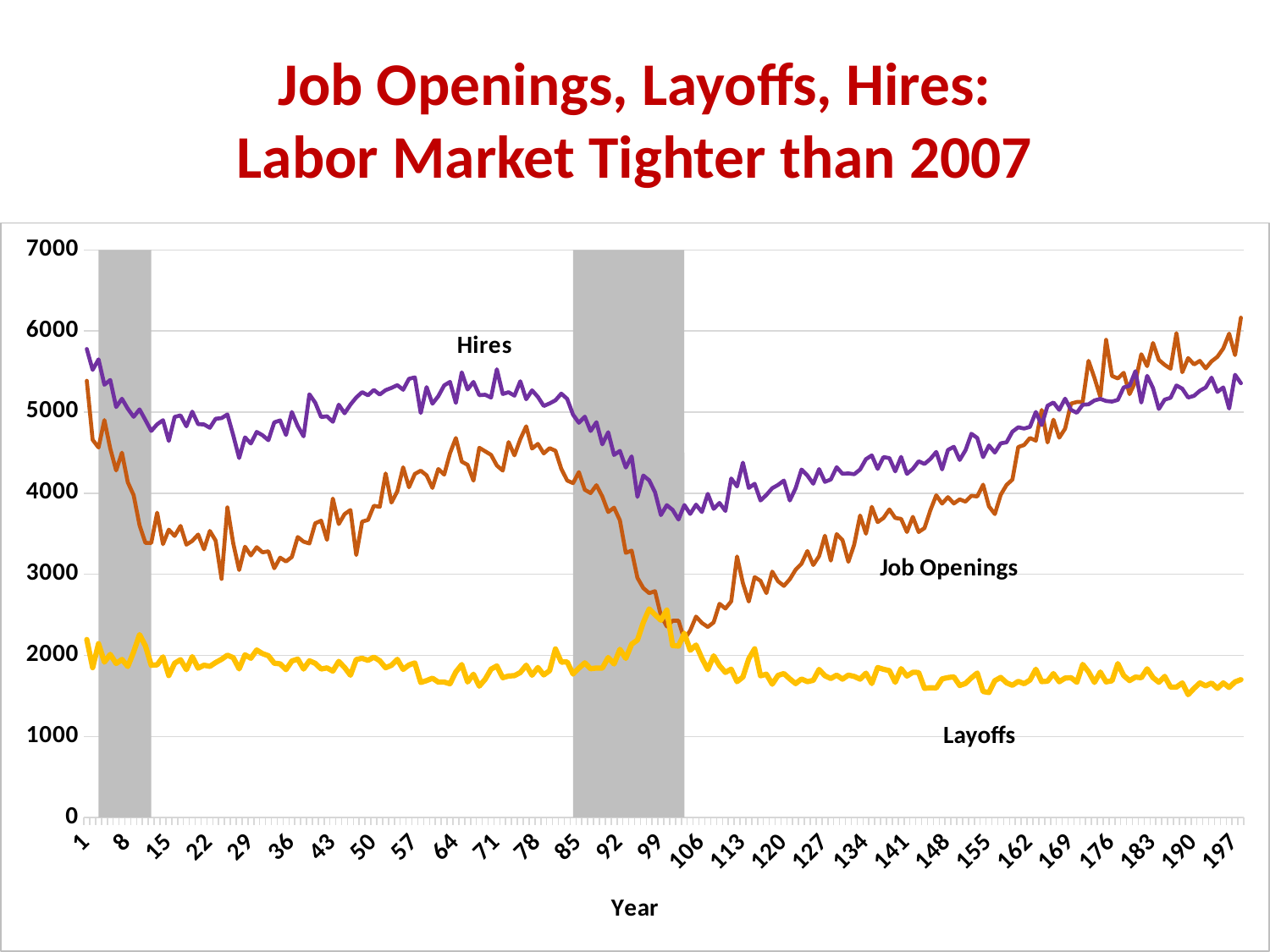
Is the value of Layoffs at year 197 greater or less than 2000? less Is the value of Hires at year 1 greater or less than 5000? greater What kind of chart is shown on the slide? Line chart Do Job Openings rise or fall between year 106 and year 197? Rise At year 1, which is higher: Hires or Job Openings? Hires At year 197, which is higher: Job Openings or Hires? Job Openings How many data series are plotted on the chart? 3 Which series has the lowest values across the whole chart? Layoffs Is the value of Job Openings at year 99 greater or less than 3000? less What is the label on the x axis of the chart? Year